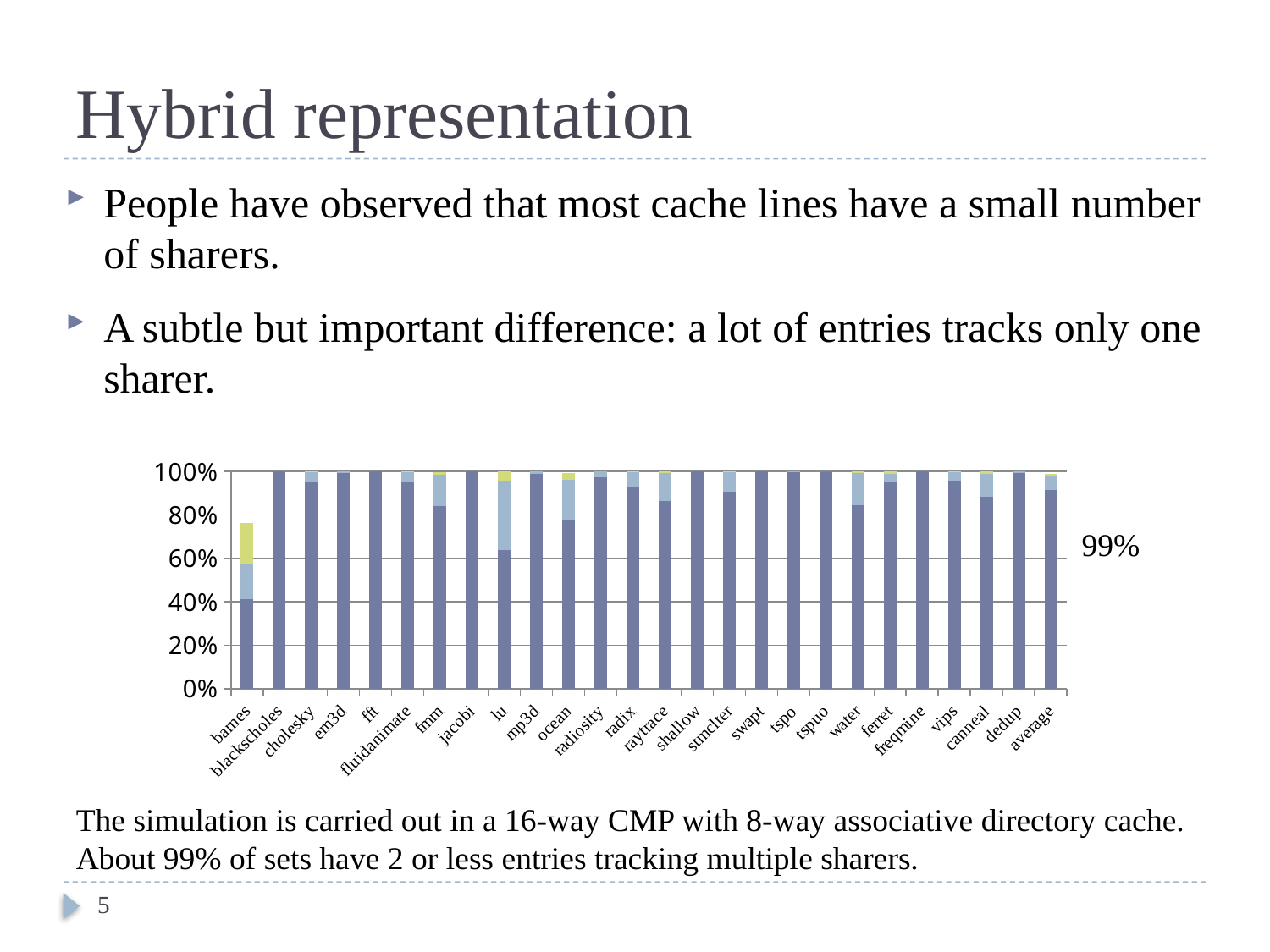
What kind of chart is shown on the slide? stacked bar chart What is the highest value shown on the y axis of the chart? 100% Which category has the lowest total bar height in the chart? barnes Is the total bar height for barnes greater or less than 80%? less Which has the taller total bar, barnes or blackscholes? blackscholes What is the last category on the x axis of the chart? average Is the dark blue segment for lu greater or less than 80%? less How many categories are shown along the x axis of the chart? 26 What percentage is annotated to the right of the chart? 99% Is the dark blue segment for blackscholes greater or less than 80%? greater Which has the larger dark blue segment, lu or jacobi? jacobi